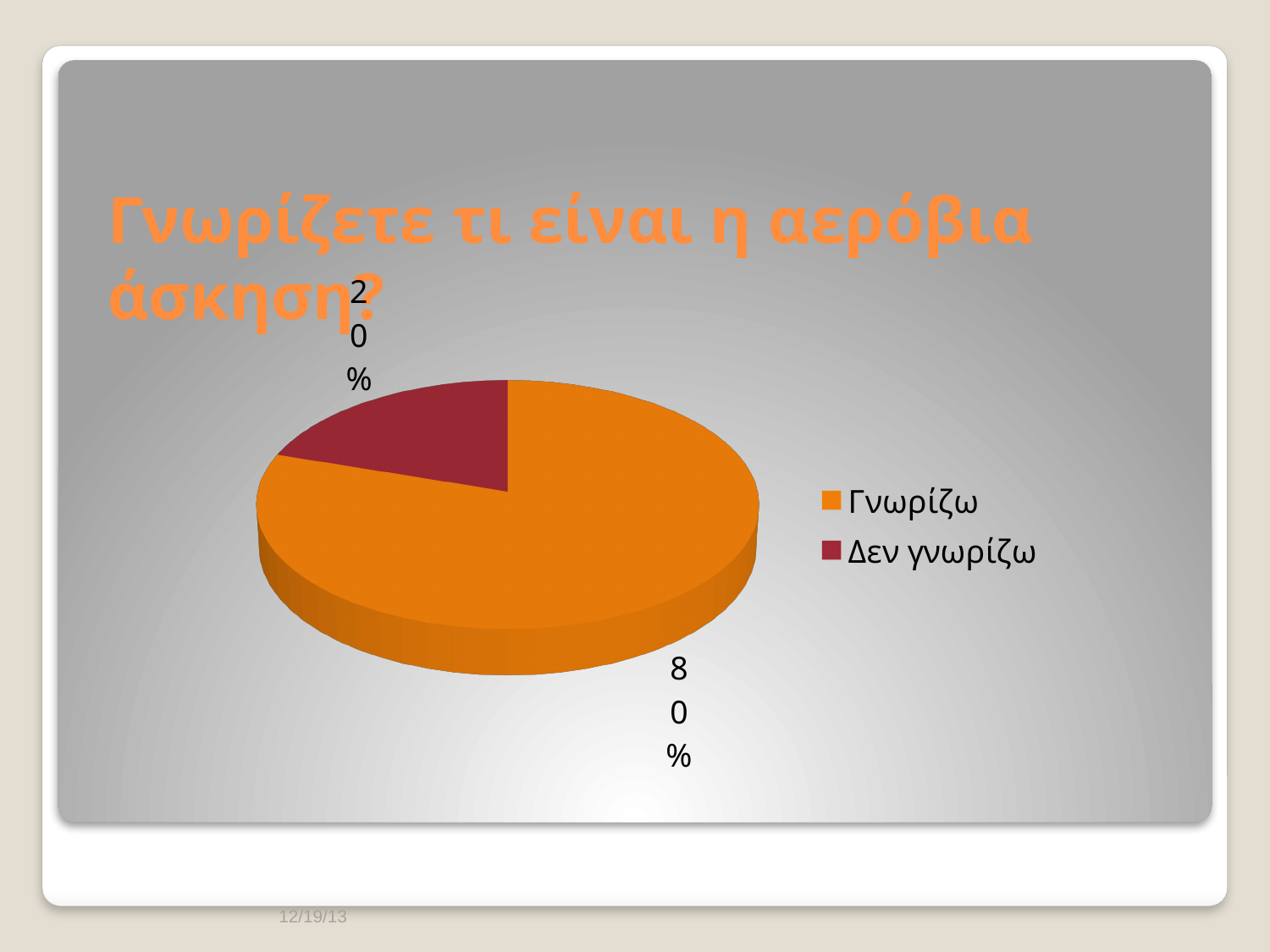
What percentage of the pie is labelled for Δεν γνωρίζω? 20% Which slice of the pie is the smallest? Δεν γνωρίζω What is the title of the slide containing the pie chart? Γνωρίζετε τι είναι η αερόβια άσκηση? What share of the pie does the Δεν γνωρίζω slice represent? 20% Which is larger, the Γνωρίζω slice or the Δεν γνωρίζω slice? Γνωρίζω What percentage of the pie is labelled for Γνωρίζω? 80% Which slice of the pie is the largest? Γνωρίζω What is the difference in percentage points between the Γνωρίζω slice and the Δεν γνωρίζω slice? 60 How many slices does the pie chart have? 2 How many entries does the legend list? 2 What kind of chart is shown on the slide? pie chart What colour is the Γνωρίζω slice in the pie chart? orange